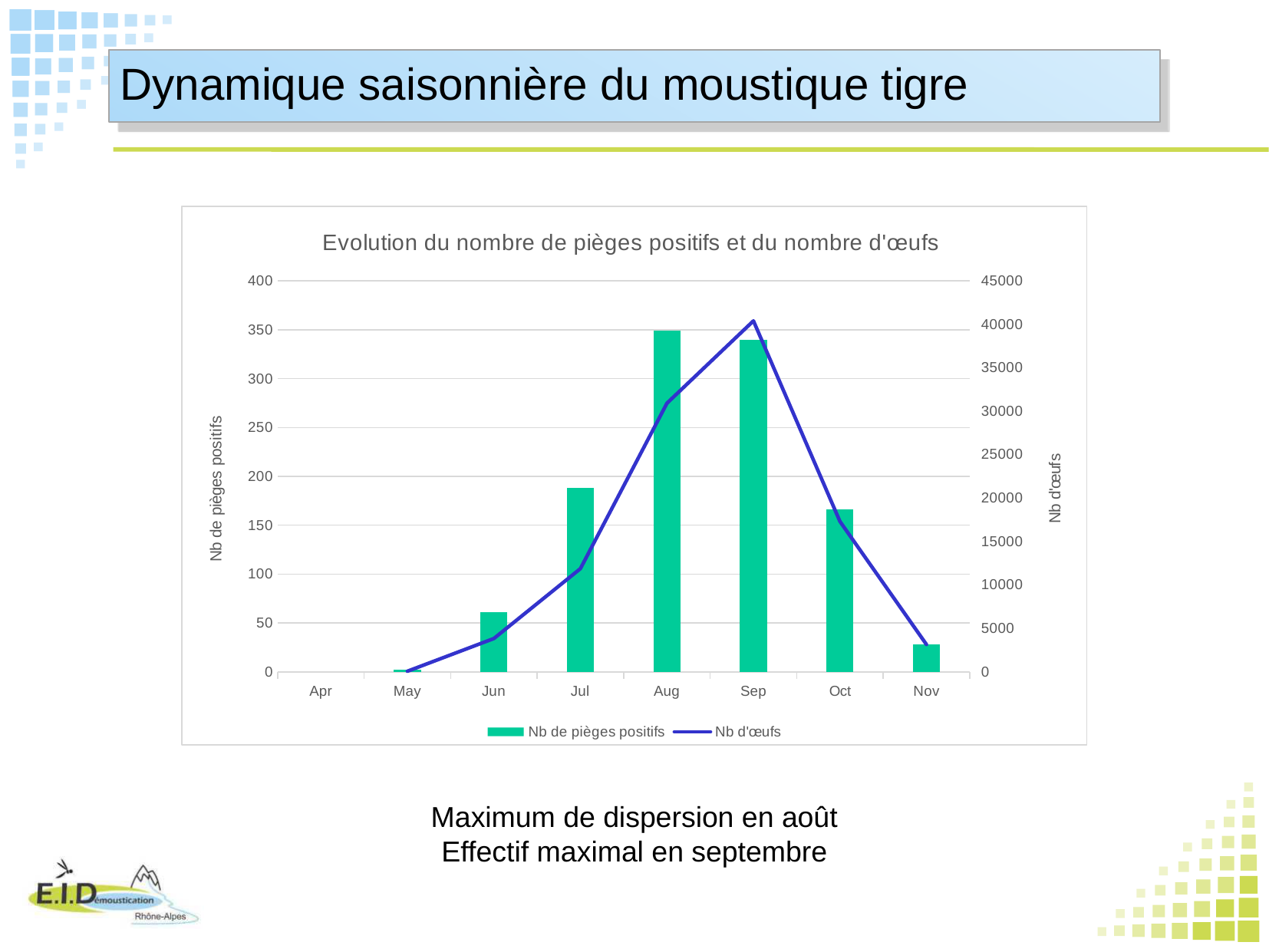
How many series does the chart legend list? 2 Which month has the highest number of 'Nb d'œufs' (the line series)? Sep Is the 'Nb de pièges positifs' value for Jun greater or less than 100? less Is the 'Nb de pièges positifs' value for Jul greater or less than 150? greater What kind of chart is shown on the slide? Combined bar and line chart How does the 'Nb d'œufs' line change from Sep to Nov? It falls Is the 'Nb de pièges positifs' value for Nov greater or less than 50? less What is the title of the chart? Evolution du nombre de pièges positifs et du nombre d'œufs How many months are shown on the x axis of the chart? 8 Which month has the larger 'Nb de pièges positifs' bar, Jul or Oct? Jul Which month has the highest bar for 'Nb de pièges positifs'? Aug